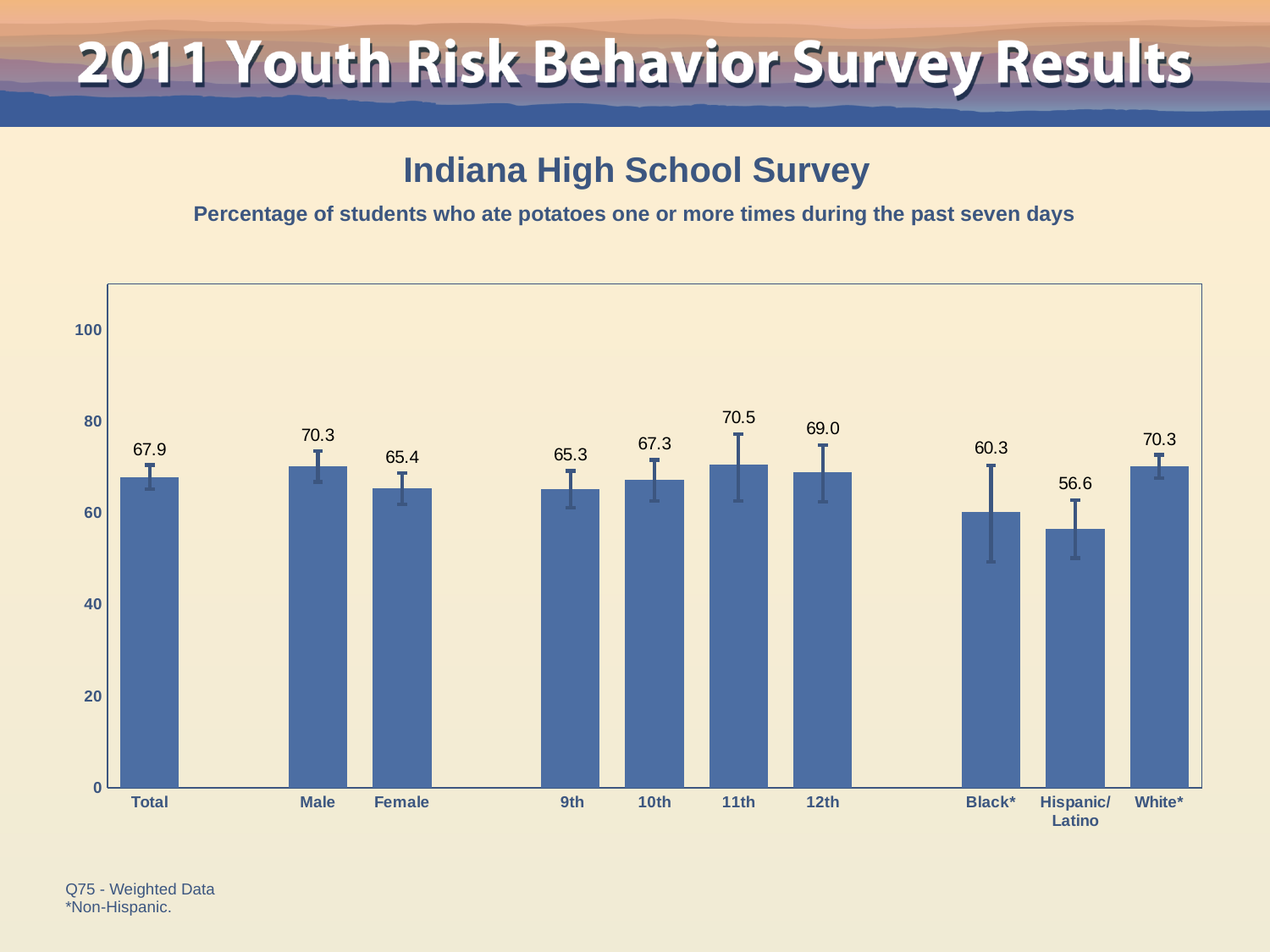
What is the value for Hispanic/Latino students? 56.6 Do the values rise or fall from 9th grade to 11th grade? rise Which is larger, the value for Black* or the value for White*? White* Which category has the lowest value? Hispanic/Latino What kind of chart is this? bar chart What is the value for Total? 67.9 Is the value for 12th grade greater or less than 60? greater What is the difference between the Male and Female values? 4.9 Which grade has the highest value? 11th How many categories are shown on the x axis? 10 What is the subtitle describing what the chart measures? Percentage of students who ate potatoes one or more times during the past seven days What is the value for 11th grade? 70.5